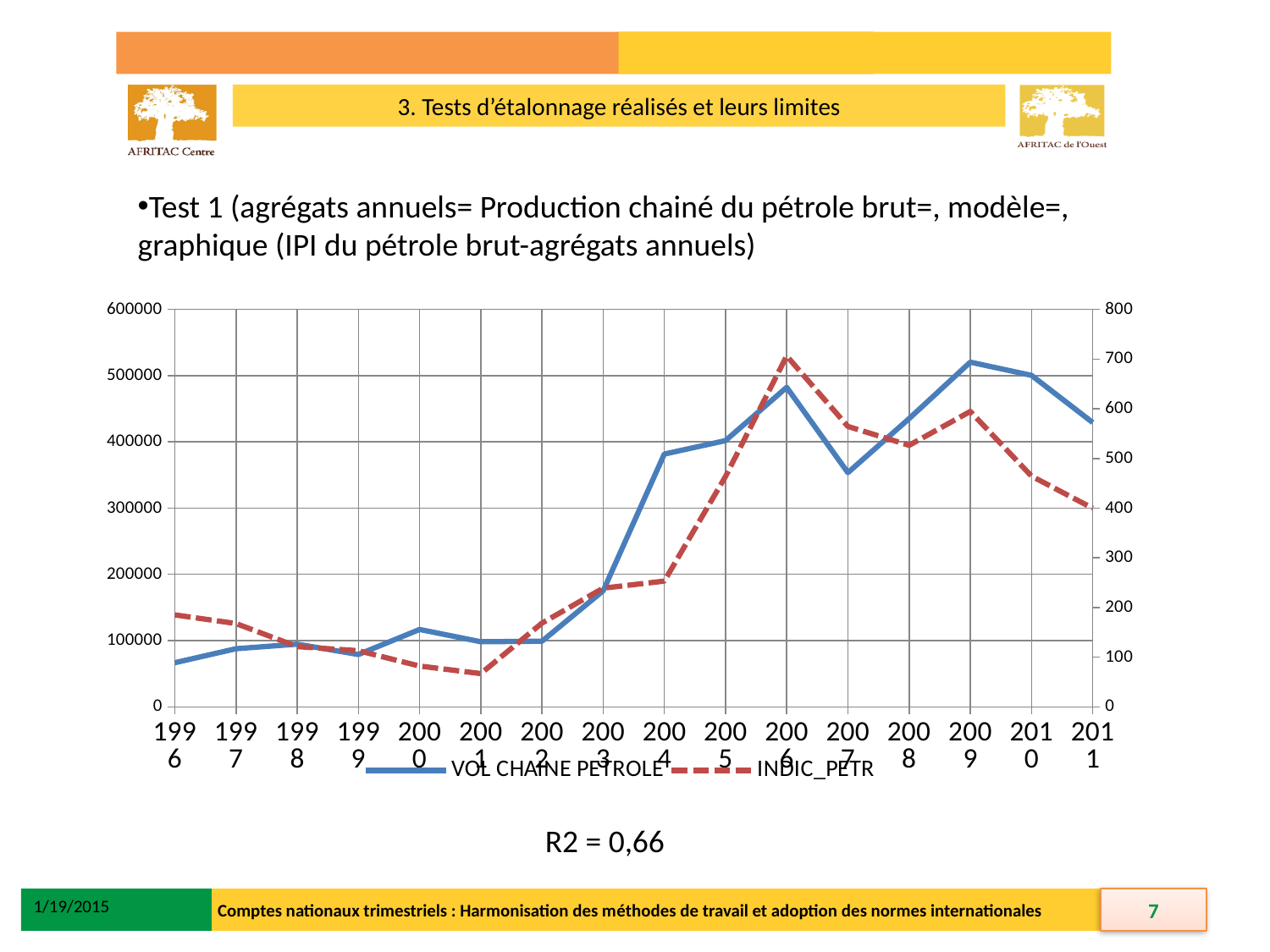
In which year is the VOL CHAINE PETROLE series at its lowest? 1996 What kind of chart is shown on the slide? line chart How many years are plotted along the x axis of the chart? 16 Does the VOL CHAINE PETROLE series rise or fall from 2009 to 2011? fall How many series does the chart legend list? 2 Which is larger for VOL CHAINE PETROLE: the value in 2007 or the value in 2009? 2009 In which year does the INDIC_PETR series reach its highest value? 2006 In which year does the VOL CHAINE PETROLE series reach its highest value? 2009 Is the value of VOL CHAINE PETROLE in 2009 greater or less than 500000? greater Is the value of INDIC_PETR in 2006 greater or less than 600? greater What are the two series named in the chart legend? VOL CHAINE PETROLE and INDIC_PETR In which year is the INDIC_PETR series at its lowest? 2001